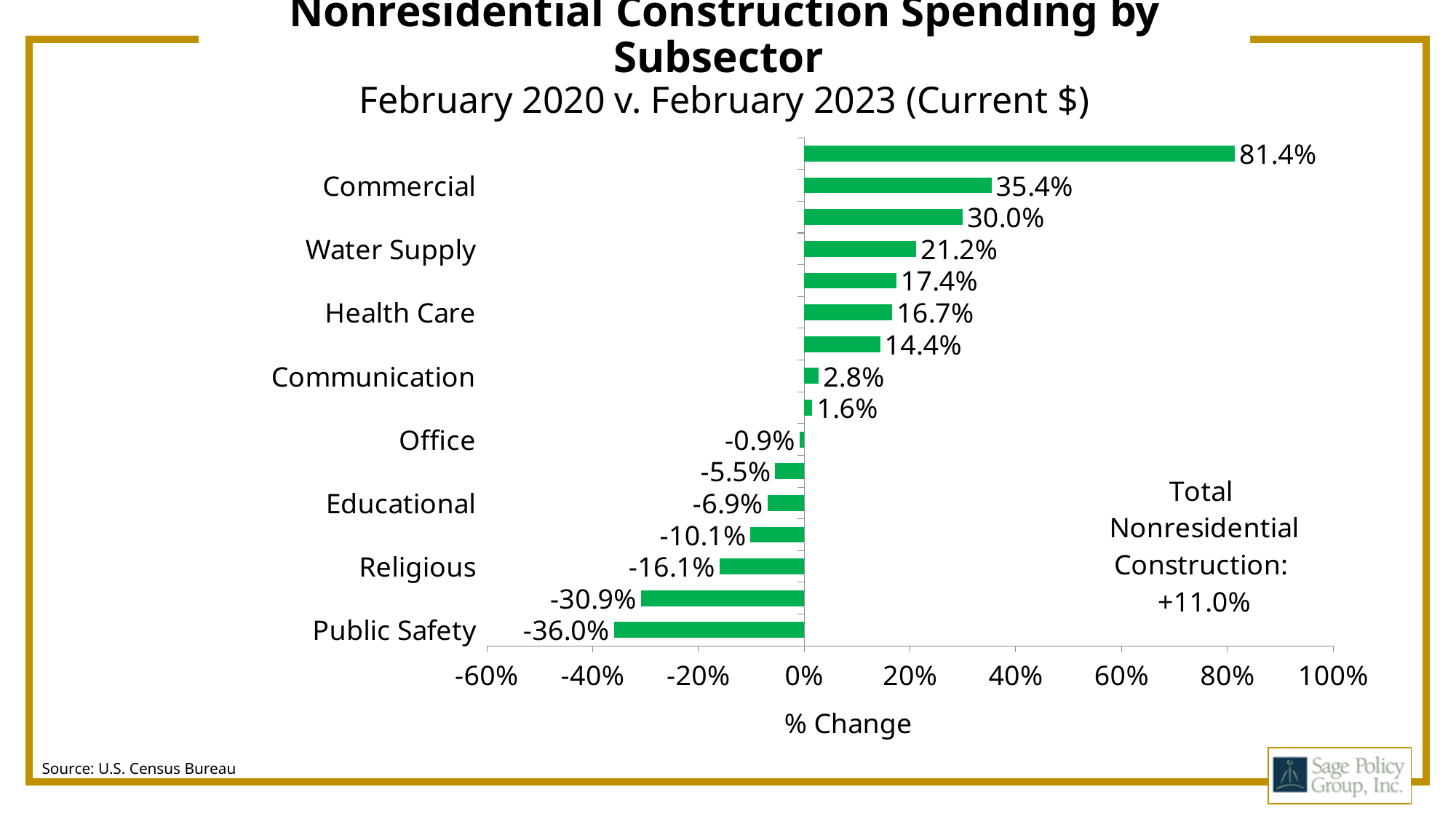
What is the difference between the values for Commercial and Water Supply? 14.2 percentage points What is the value for Office? -0.9% What is the x-axis title of the chart? % Change How many bars are plotted on the chart? 16 What is the value for Public Safety? -36.0% What kind of chart is shown? Bar chart Which is larger, the value for Health Care or the value for Communication? Health Care What is the value for Water Supply? 21.2% What is the largest value shown on the chart? 81.4% What is the value for Religious? -16.1% Which labeled subsector has the lowest value? Public Safety What is the value for Commercial? 35.4%